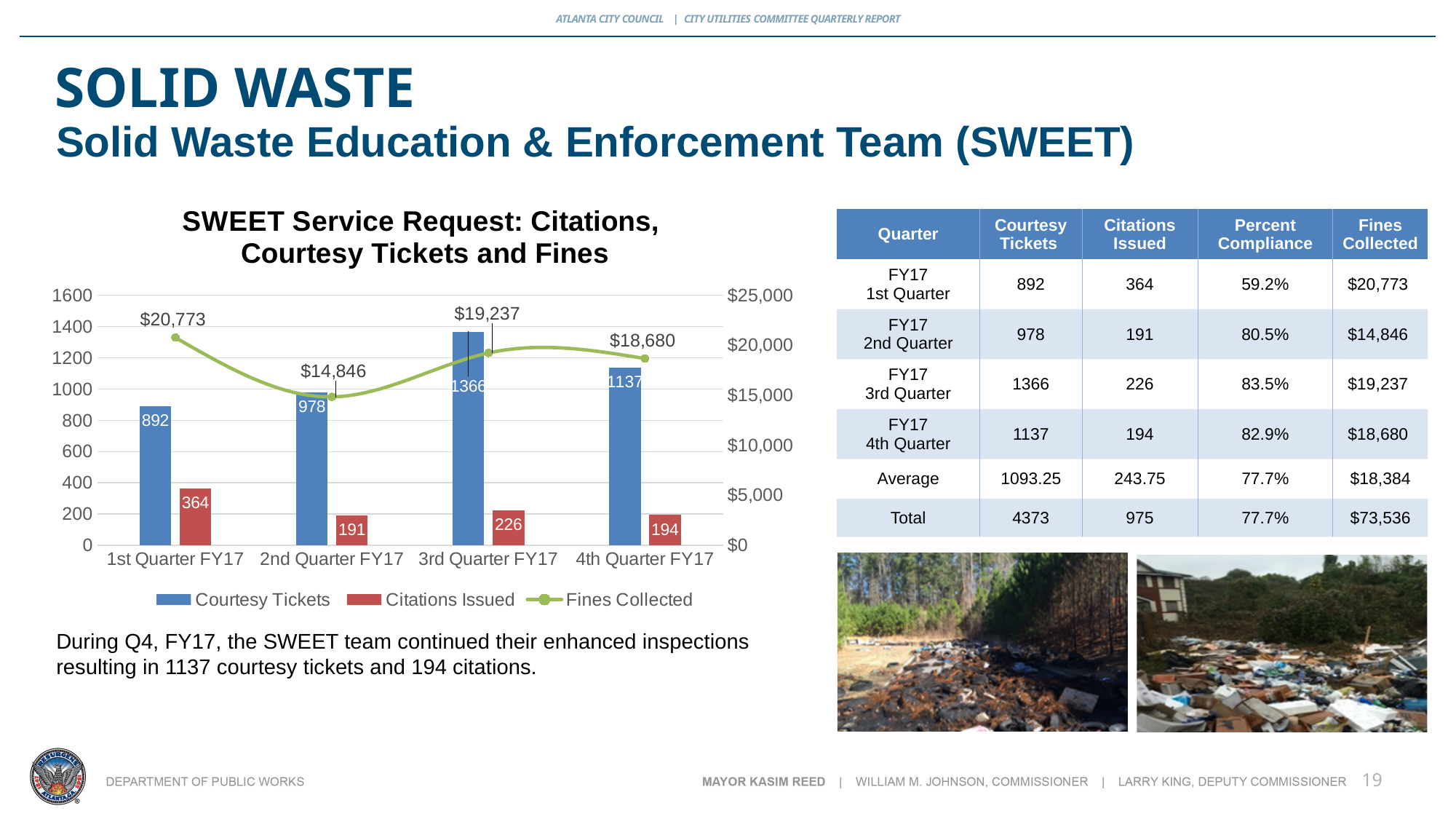
Which quarter has the lowest number of Citations Issued? 2nd Quarter FY17 How many series does the chart legend list? 3 What is the title of the chart? SWEET Service Request: Citations, Courtesy Tickets and Fines Which is larger: Citations Issued in 3rd Quarter FY17 or in 4th Quarter FY17? 3rd Quarter FY17 What is the difference in Courtesy Tickets between 3rd Quarter FY17 and 1st Quarter FY17? 474 Which quarter has the highest number of Courtesy Tickets? 3rd Quarter FY17 What is the value of Fines Collected for 2nd Quarter FY17? $14,846 How many quarters are shown on the x axis of the chart? 4 What is the number of Courtesy Tickets for 3rd Quarter FY17? 1366 What is the number of Citations Issued for 1st Quarter FY17? 364 Which quarter has the highest Fines Collected? 1st Quarter FY17 What kind of chart is used to show Courtesy Tickets and Citations Issued? Bar chart